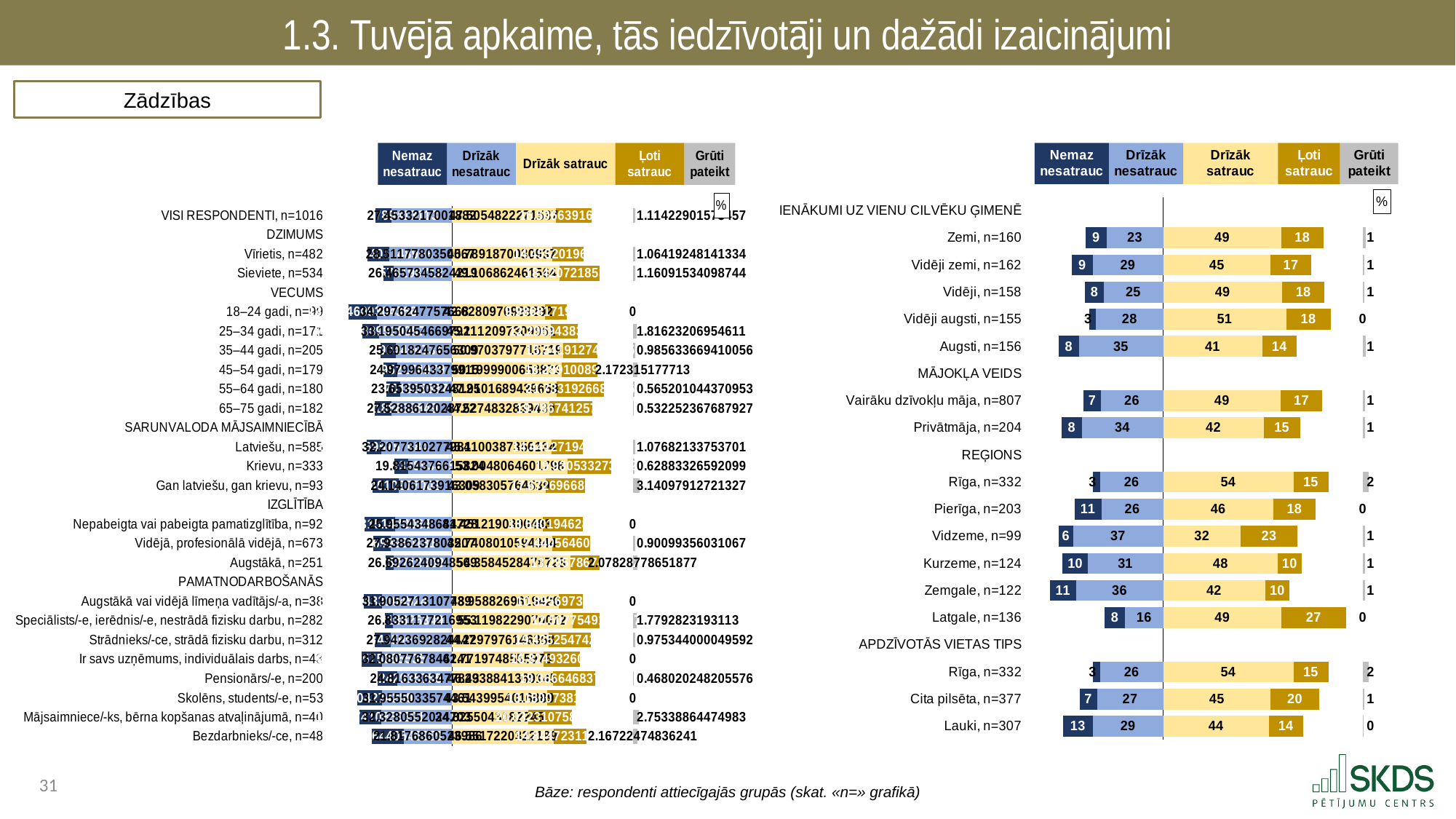
On the right-hand chart, what is the difference between the 'Drīzāk satrauc' values for Vairāku dzīvokļu māja, n=807 and Privātmāja, n=204? 7 On the right-hand chart, which region under REĢIONS has the lowest 'Drīzāk nesatrauc' value? Latgale, n=136 On the right-hand chart, what is the 'Nemaz nesatrauc' value for Lauki, n=307? 13 On the right-hand chart, what is the total of the bar for Zemi, n=160 across all five series? 100 On the right-hand chart, which region under REĢIONS has the highest 'Ļoti satrauc' value? Latgale, n=136 On the right-hand chart, what is the 'Drīzāk nesatrauc' value for Augsti, n=156? 35 On the right-hand chart, which has a larger 'Ļoti satrauc' value: Vidzeme, n=99 or Kurzeme, n=124? Vidzeme, n=99 What type of chart is the right-hand chart? Stacked bar chart On the right-hand chart, what is the 'Drīzāk satrauc' value for Rīga, n=332? 54 How many series does the legend of the right-hand chart list? 5 On the right-hand chart, what is the 'Ļoti satrauc' value for Latgale, n=136? 27 On the right-hand chart, how many income groups are listed under IENĀKUMI UZ VIENU CILVĒKU ĢIMENĒ? 5